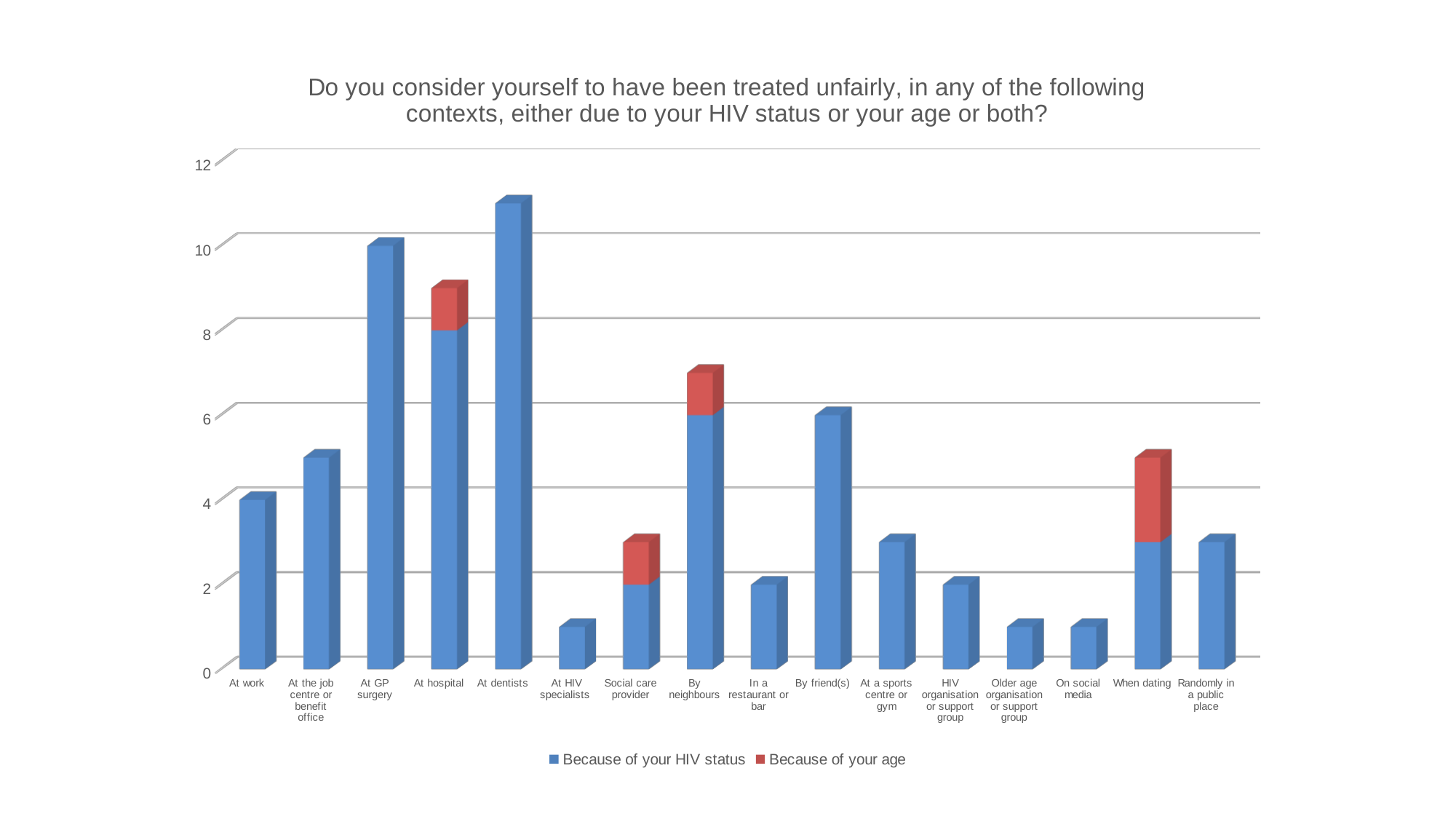
Is the total height of the Social care provider bar greater or less than 4? less Is the total height of the When dating bar greater or less than 4? greater How many contexts (categories) are shown along the x axis? 16 What are the two series named in the legend? Because of your HIV status; Because of your age Which is larger, the bar for By friend(s) or the bar for On social media? By friend(s) Is the value for At HIV specialists greater or less than 2? less What kind of chart is shown on the slide? Bar chart What colour represents the series 'Because of your age'? Red Which is larger, the bar for At GP surgery or the bar for At work? At GP surgery Which context has the highest bar? At dentists How many series does the legend list? 2